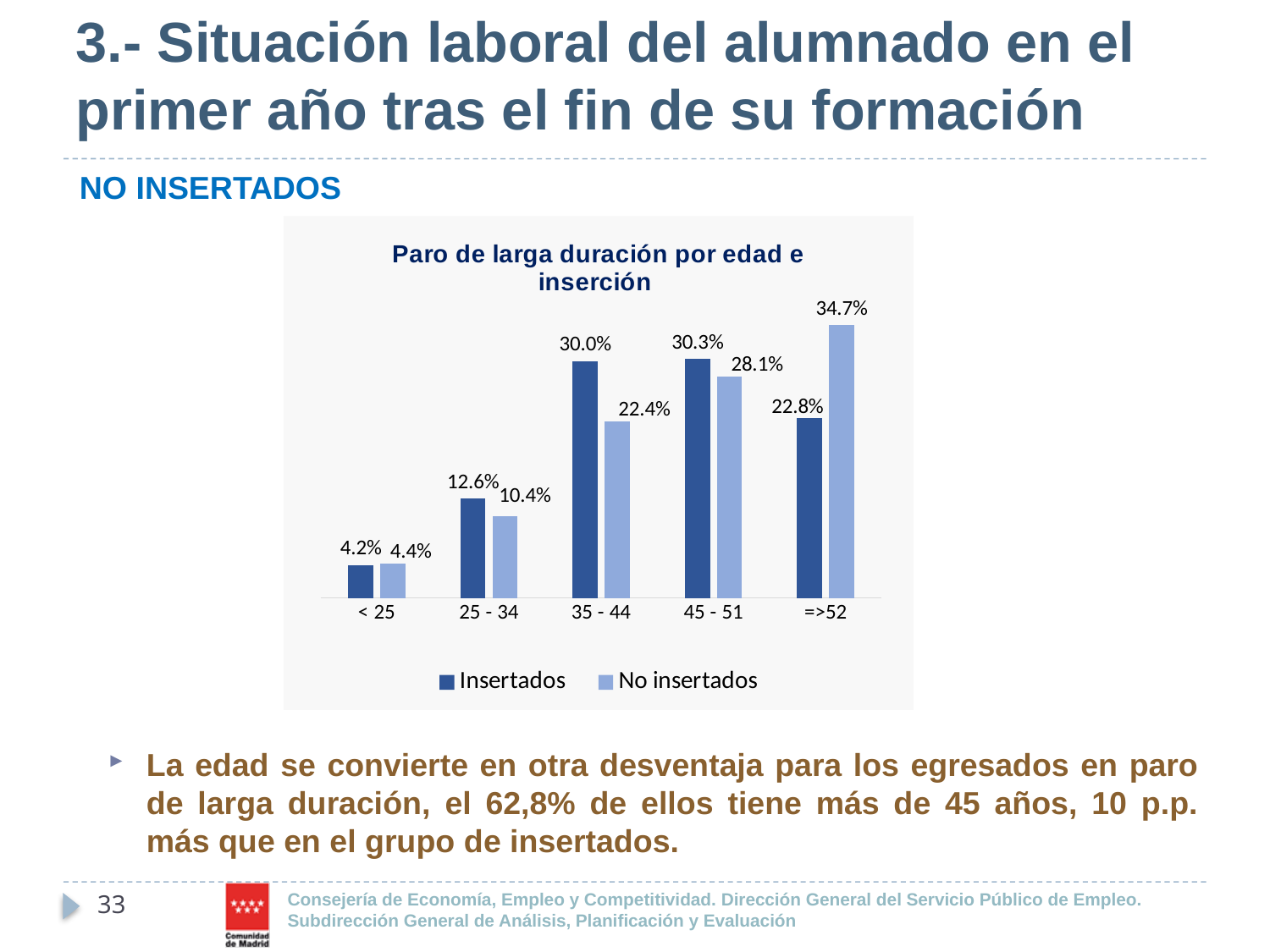
What is the value for Insertados in the 35 - 44 age group? 30.0% What is the title of the chart? Paro de larga duración por edad e inserción What is the difference between Insertados and No insertados in the 35 - 44 age group? 7.6 percentage points What is the value for No insertados in the =>52 age group? 34.7% Which age group has the lowest value for Insertados? < 25 Which age group has the highest value for No insertados? =>52 What is the value for No insertados in the 25 - 34 age group? 10.4% How many series does the legend list? 2 How many age groups are shown on the x axis? 5 What is the difference between Insertados and No insertados in the 45 - 51 age group? 2.2 percentage points What kind of chart is shown on the slide? Bar chart Which is larger in the =>52 age group, Insertados or No insertados? No insertados